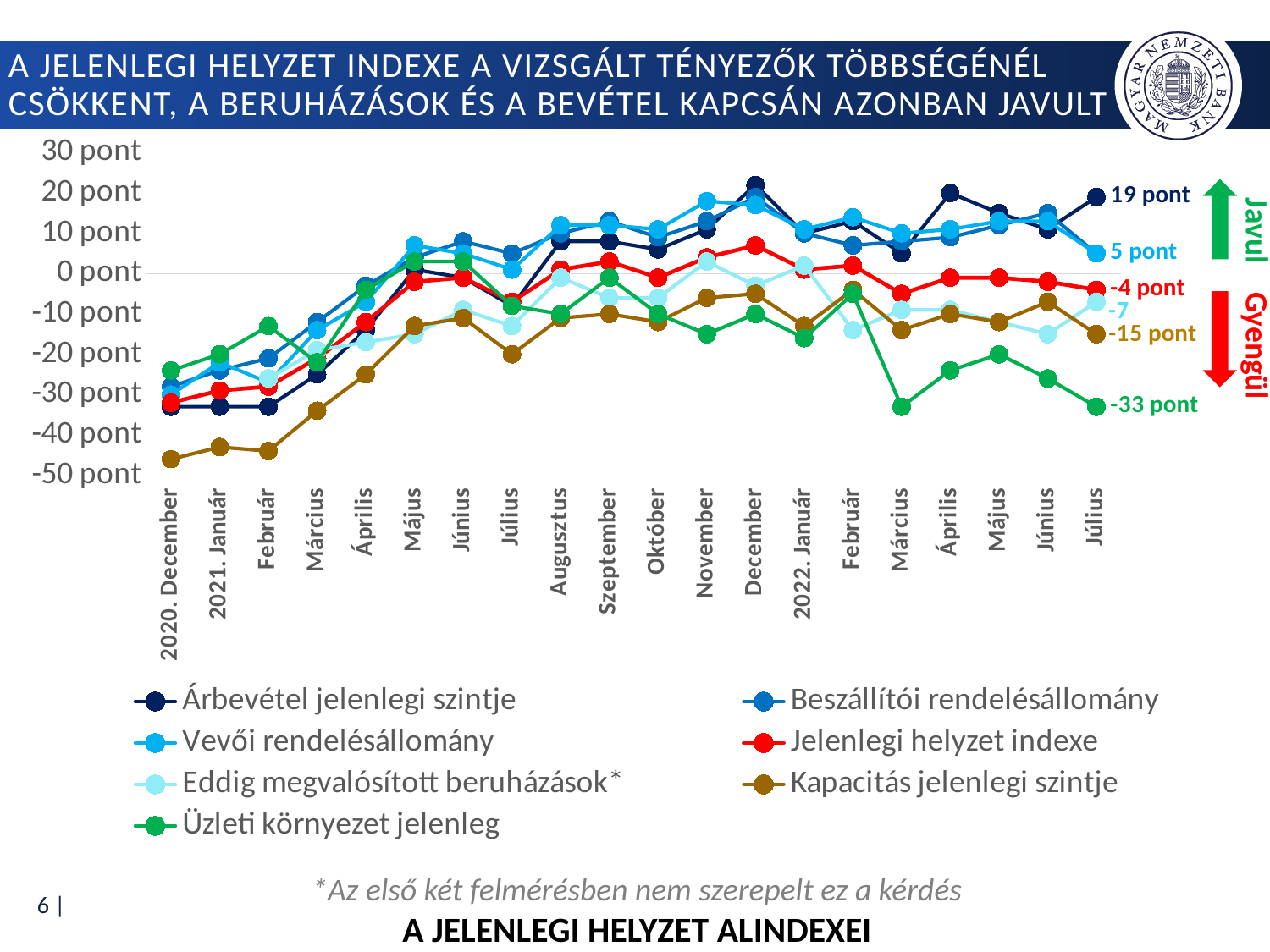
What is the value of Jelenlegi helyzet indexe in Július 2022? -4 pont How many series does the legend list? 7 Which series has the highest value in Július 2022? Árbevétel jelenlegi szintje Is the value of Kapacitás jelenlegi szintje in 2020. December greater or less than -40 pont? less Does Üzleti környezet jelenleg rise or fall from Május 2022 to Július 2022? fall What is the difference between Árbevétel jelenlegi szintje and Üzleti környezet jelenleg in Július 2022? 52 pont What kind of chart is shown on the slide? line chart What is the value of Kapacitás jelenlegi szintje in Július 2022? -15 pont Which series has the lowest value in Július 2022? Üzleti környezet jelenleg What is the value of Üzleti környezet jelenleg in Július 2022? -33 pont What is the value of Árbevétel jelenlegi szintje in Július 2022? 19 pont How many months are shown on the x axis? 20